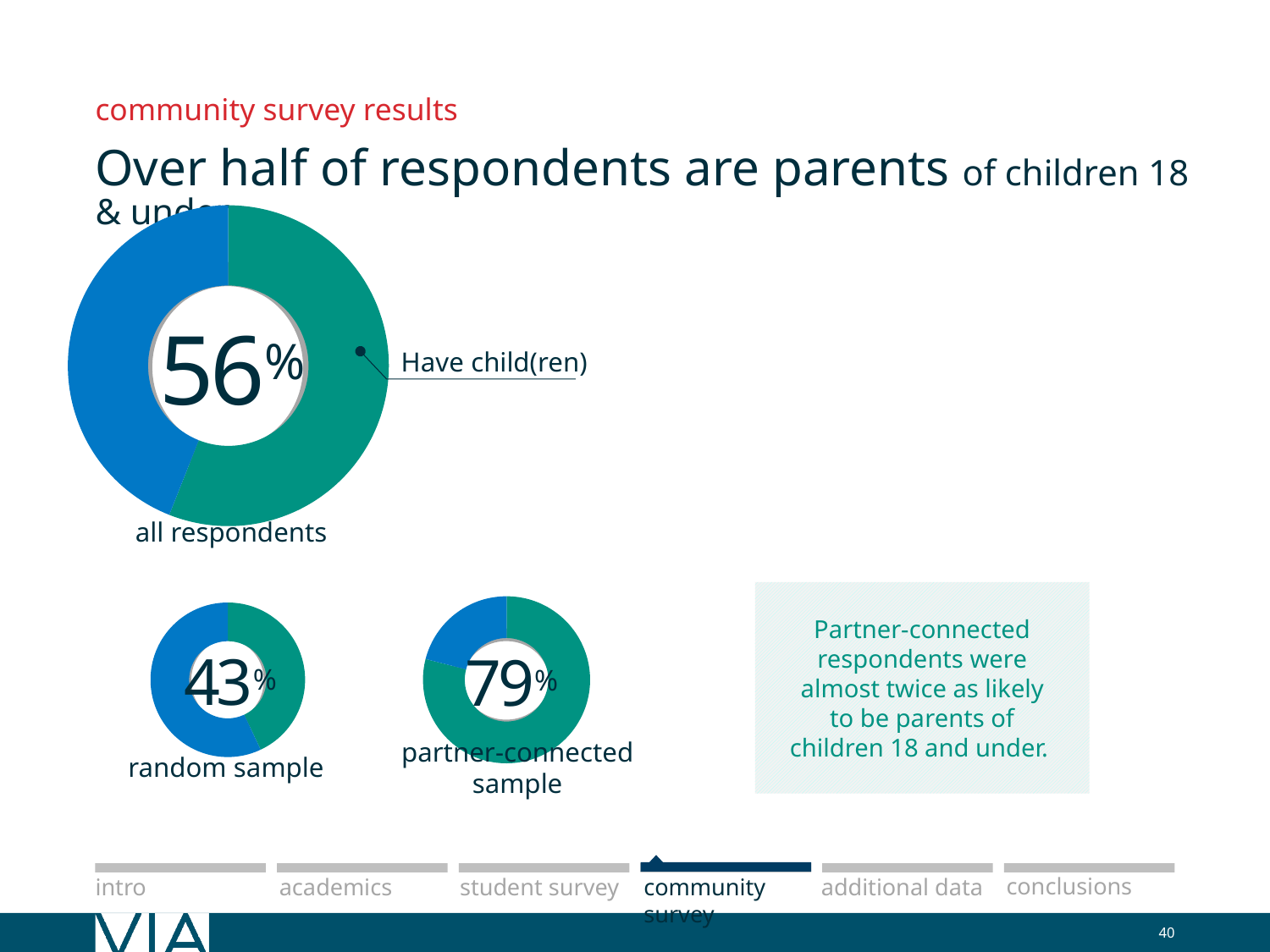
What kind of chart is used to show the share of respondents with child(ren)? pie chart (donut) Which of the three charts shows the highest percentage of respondents with child(ren)? partner-connected sample What is the difference in percentage points between the 'partner-connected sample' and 'random sample' charts for respondents with child(ren)? 36 In the 'all respondents' chart, what share of the pie does the green slice represent? 56% How many charts are shown on the slide? 3 In the 'random sample' chart, what percentage of respondents have child(ren)? 43% What is the difference in percentage points between the 'all respondents' and 'random sample' charts for respondents with child(ren)? 13 In the 'all respondents' chart, what percentage of respondents have child(ren)? 56% In the 'partner-connected sample' chart, what percentage of respondents have child(ren)? 79% What label is attached to the green segment of the 'all respondents' chart? Have child(ren) Which is larger: the percentage with child(ren) in the 'random sample' chart or in the 'all respondents' chart? all respondents Which of the three charts shows the lowest percentage of respondents with child(ren)? random sample